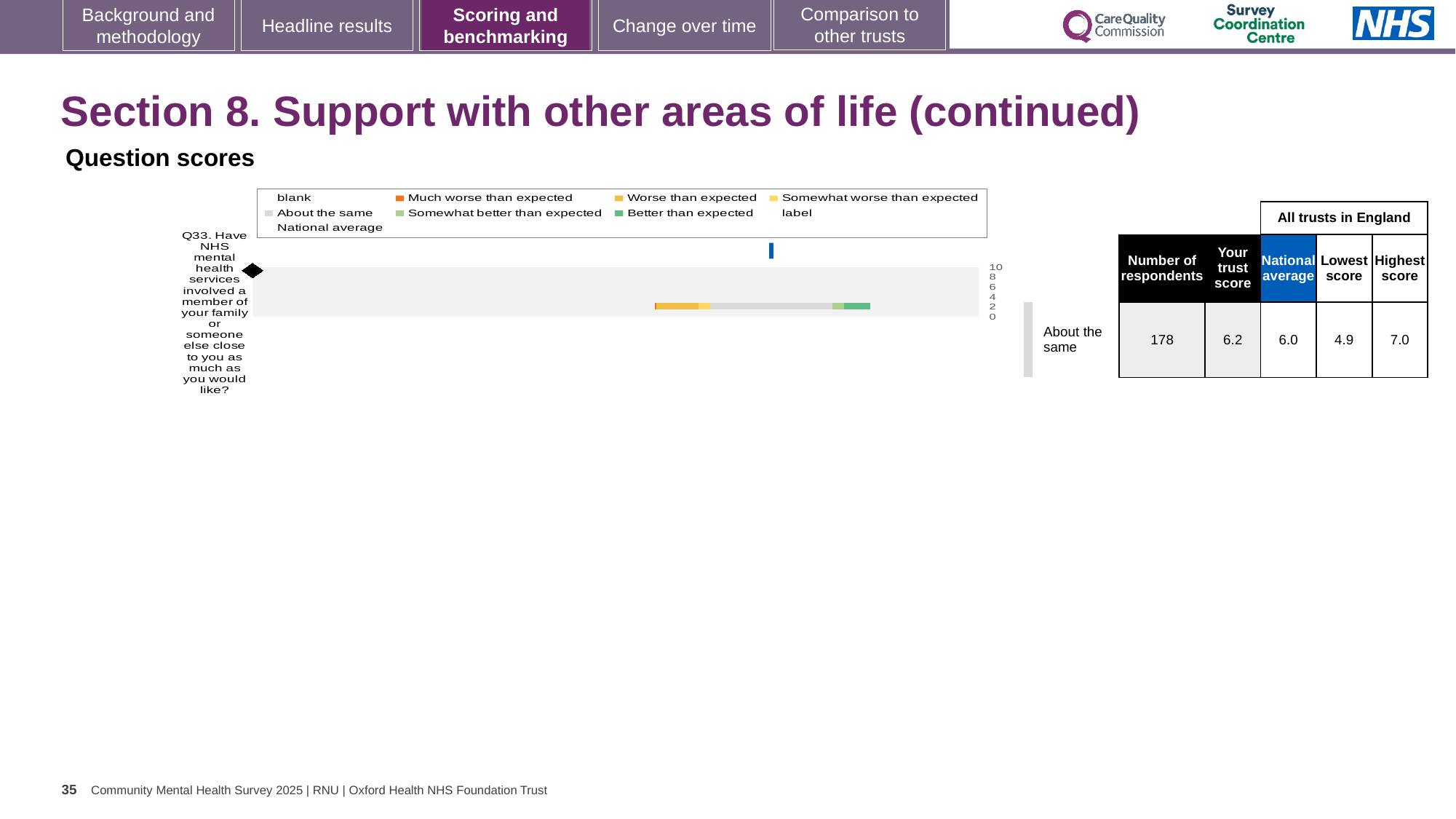
How many respondents answered Q33? 178 What is the trust's score for Q33 according to the table next to the chart? 6.2 What kind of chart is used to show the Q33 question score? bar chart Is the trust's score for Q33 higher or lower than the national average? higher What is the difference between the highest score and the lowest score for Q33? 2.1 How many entries does the chart legend list? 9 What is the national average score for Q33? 6.0 What is the highest score among all trusts in England for Q33? 7.0 How many questions are plotted on the chart? 1 What is the highest value shown on the chart's axis? 10 What is the lowest score among all trusts in England for Q33? 4.9 What benchmark category is the trust's Q33 score placed in? About the same